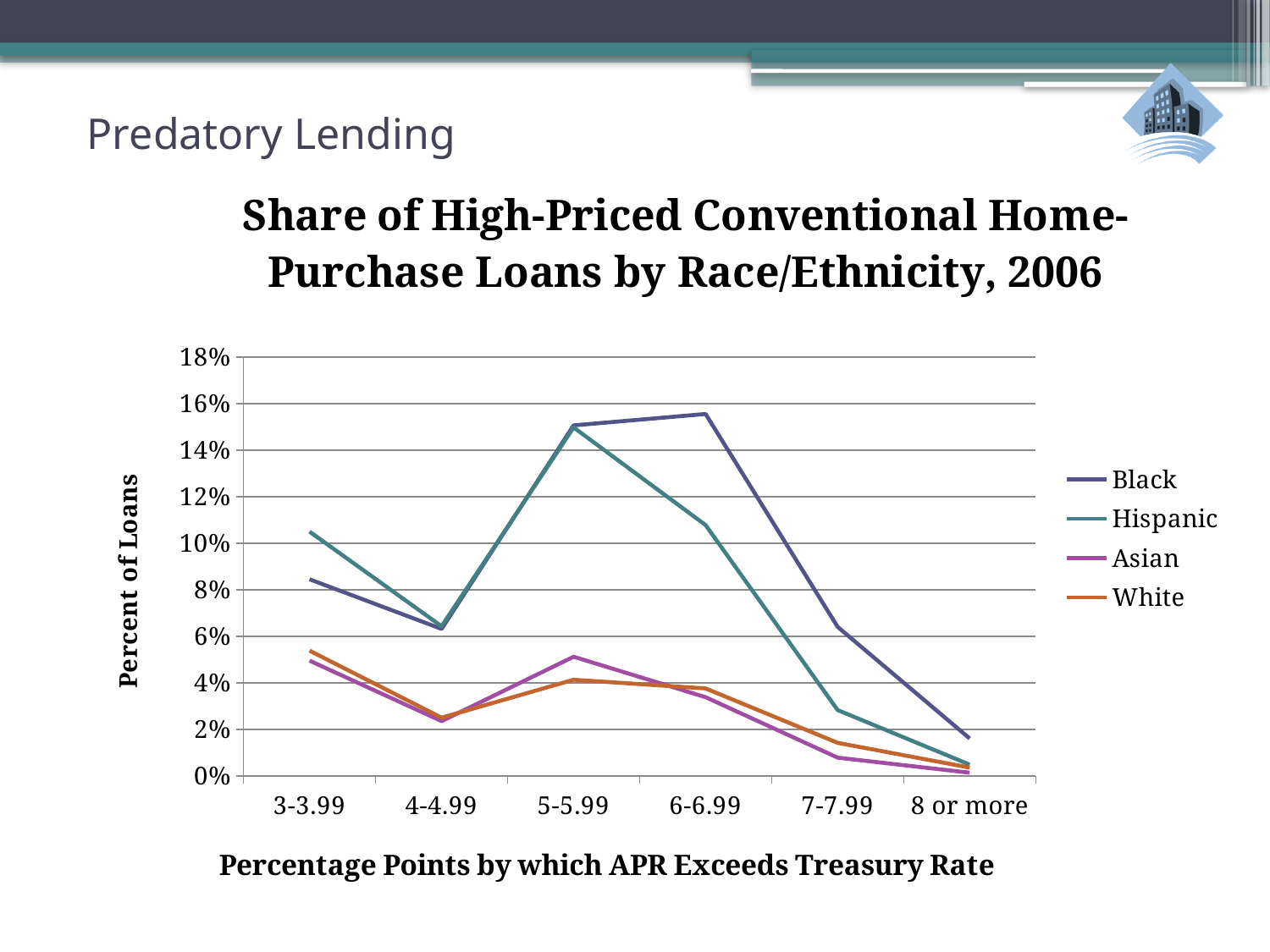
Which series has the highest value in the 3-3.99 category? Hispanic How many categories are shown on the x axis? 6 In the 7-7.99 category, which is larger: the value for Black or the value for Hispanic? Black Which series has the highest value in the 6-6.99 category? Black Is the value for Black in the 6-6.99 category greater or less than 14%? greater In which category is the value for Black lowest? 8 or more What kind of chart is shown on the slide? Line chart Does the Hispanic line rise or fall from 5-5.99 to 8 or more? Falls What is the label of the y axis? Percent of Loans Is the value for Hispanic in the 7-7.99 category greater or less than 4%? less Is the value for Asian in the 5-5.99 category greater or less than 4%? greater How many series does the legend list? 4